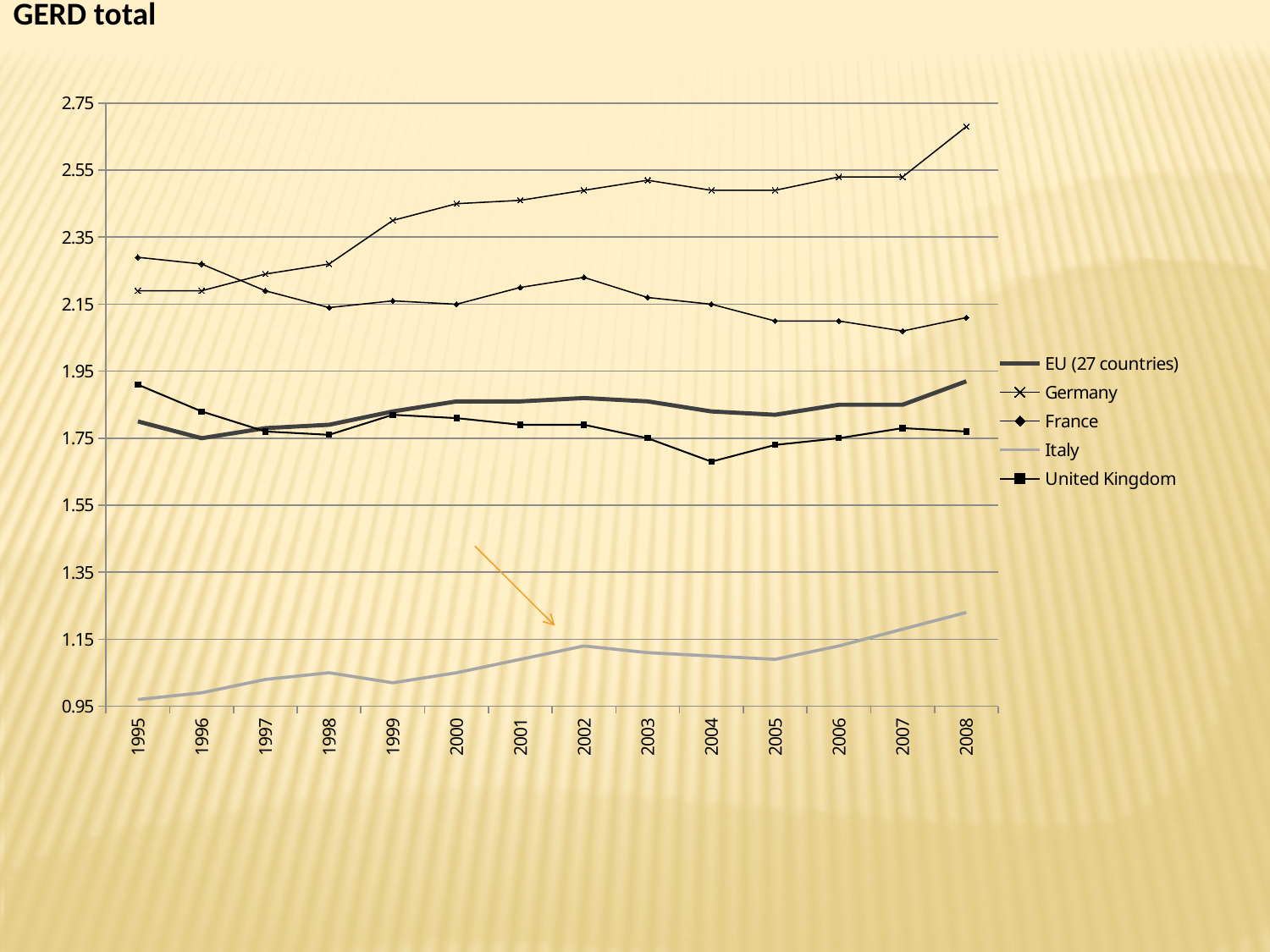
Is the value for the United Kingdom in 2004 greater or less than 1.75? less Does the Italy line generally rise or fall from 1995 to 2008? rise In which year is the United Kingdom at its lowest value? 2004 How many years are shown on the x axis? 14 Which series has the lowest values across all years? Italy Is the value for Germany in 2008 greater or less than 2.55? greater How many series does the legend list? 5 What kind of chart is shown on the slide? Line chart Which is larger in 1995, the value for France or the value for Germany? France Is the value for Italy in 1995 greater or less than 1.15? less Which series has the highest value in 2008? Germany In which year does Germany reach its highest value? 2008